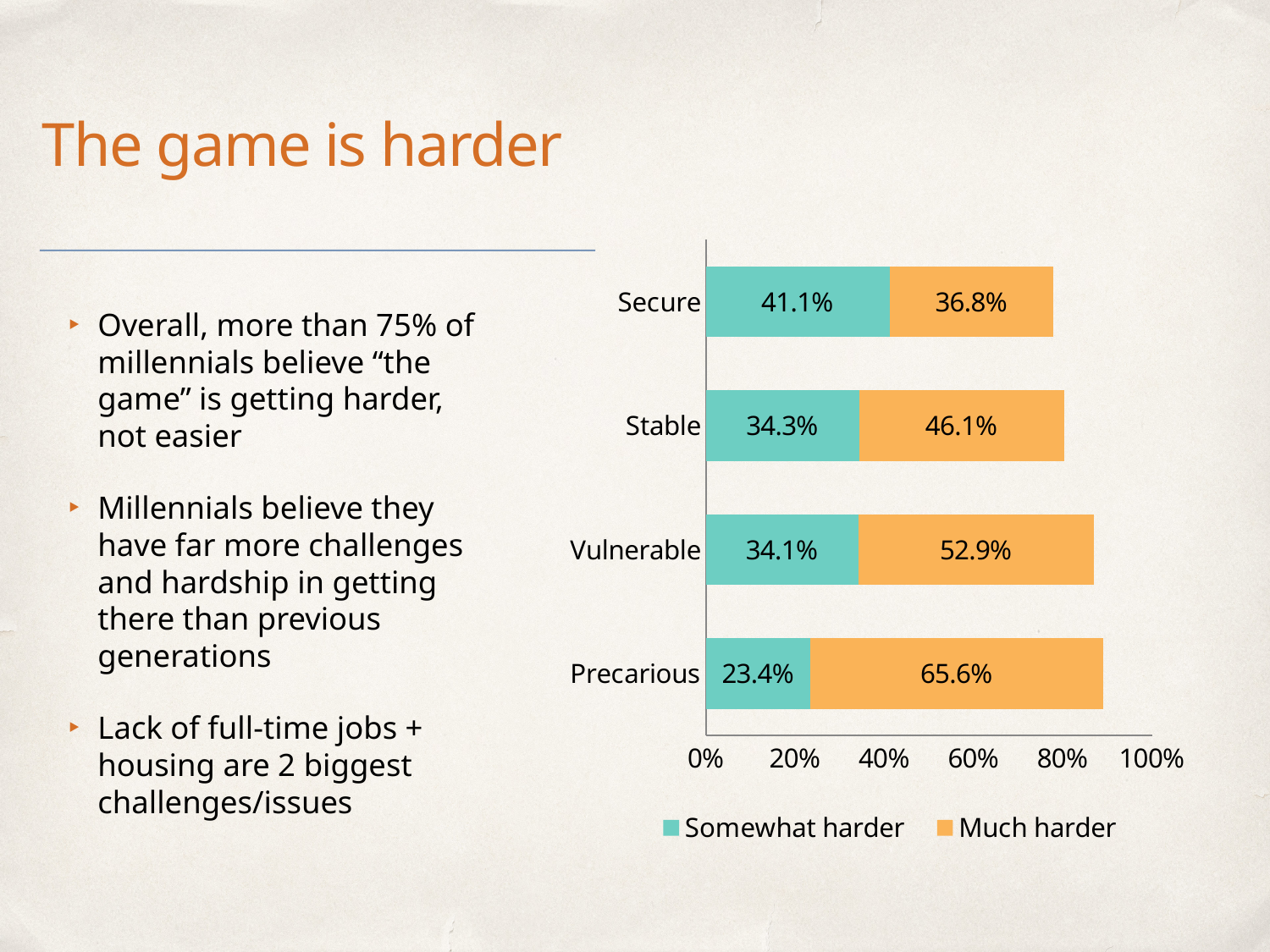
Which is larger for Vulnerable: the "Somewhat harder" value or the "Much harder" value? Much harder Which category has the lowest "Somewhat harder" value? Precarious What is the "Somewhat harder" value for Secure? 41.1% What is the total of the stacked bar for Secure? 77.9% How many categories are shown on the chart? 4 What is the total of the stacked bar for Vulnerable? 87.0% Which category has the highest "Much harder" value? Precarious What is the "Much harder" value for Precarious? 65.6% How many series does the legend list? 2 What is the "Much harder" value for Stable? 46.1% What is the difference between the "Much harder" values for Precarious and Secure? 28.8% What kind of chart is shown on the slide? Stacked bar chart